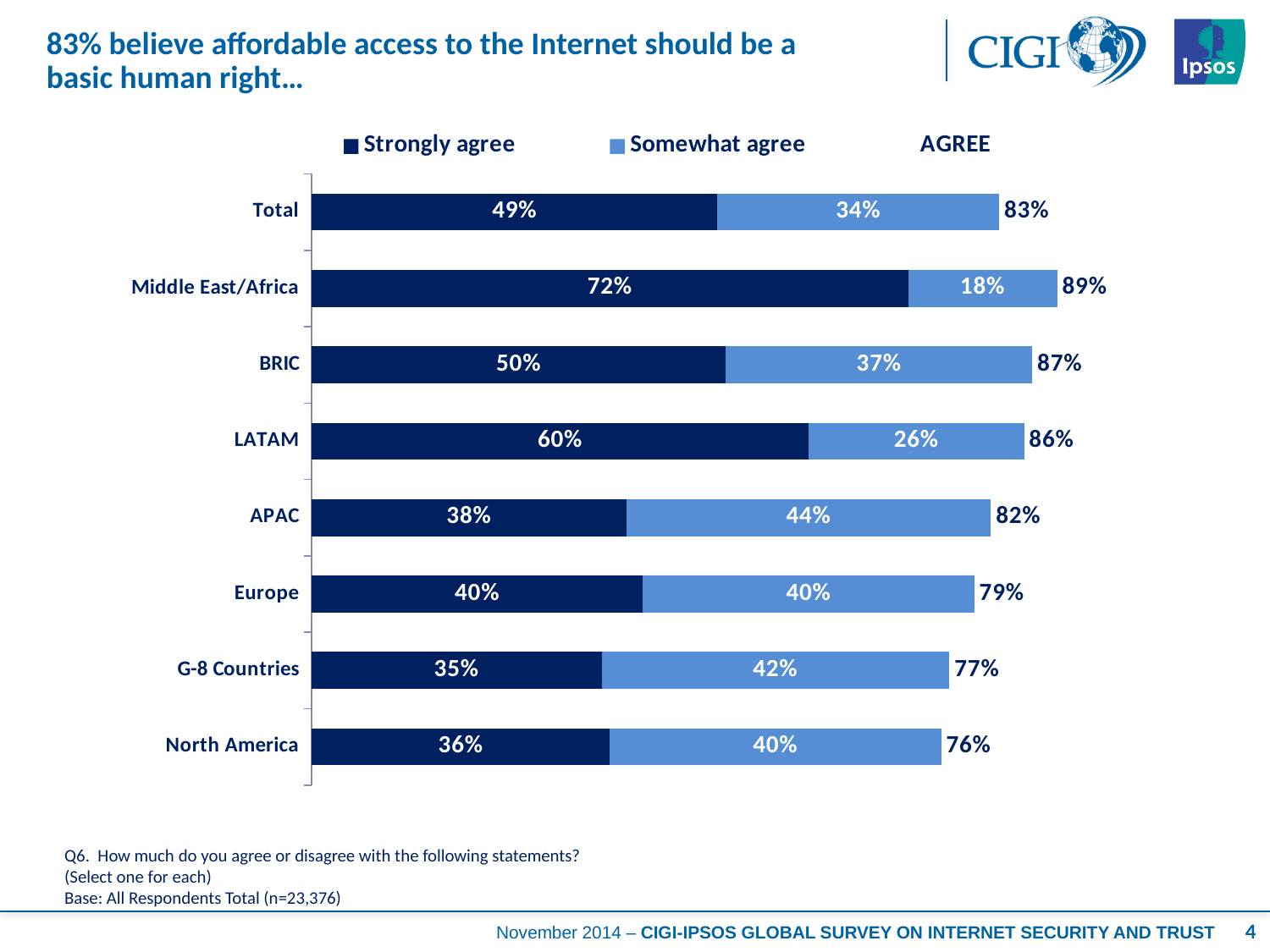
How many categories (bars) are shown on the chart? 8 Which legend entry is shown in the darker blue colour? Strongly agree What is the difference between the 'Strongly agree' values for LATAM and BRIC? 10% How many series does the legend list? 3 Which is larger, the 'Somewhat agree' value for G-8 Countries or for Europe? G-8 Countries What is the 'Strongly agree' value for Middle East/Africa? 72% What is the 'Somewhat agree' value for APAC? 44% What kind of chart is shown on the slide? Stacked bar chart Which region has the highest 'Strongly agree' value? Middle East/Africa What is the total of the stacked bar for Total (Strongly agree plus Somewhat agree)? 83% What is the AGREE total shown for North America? 76% Which region has the lowest AGREE total? North America